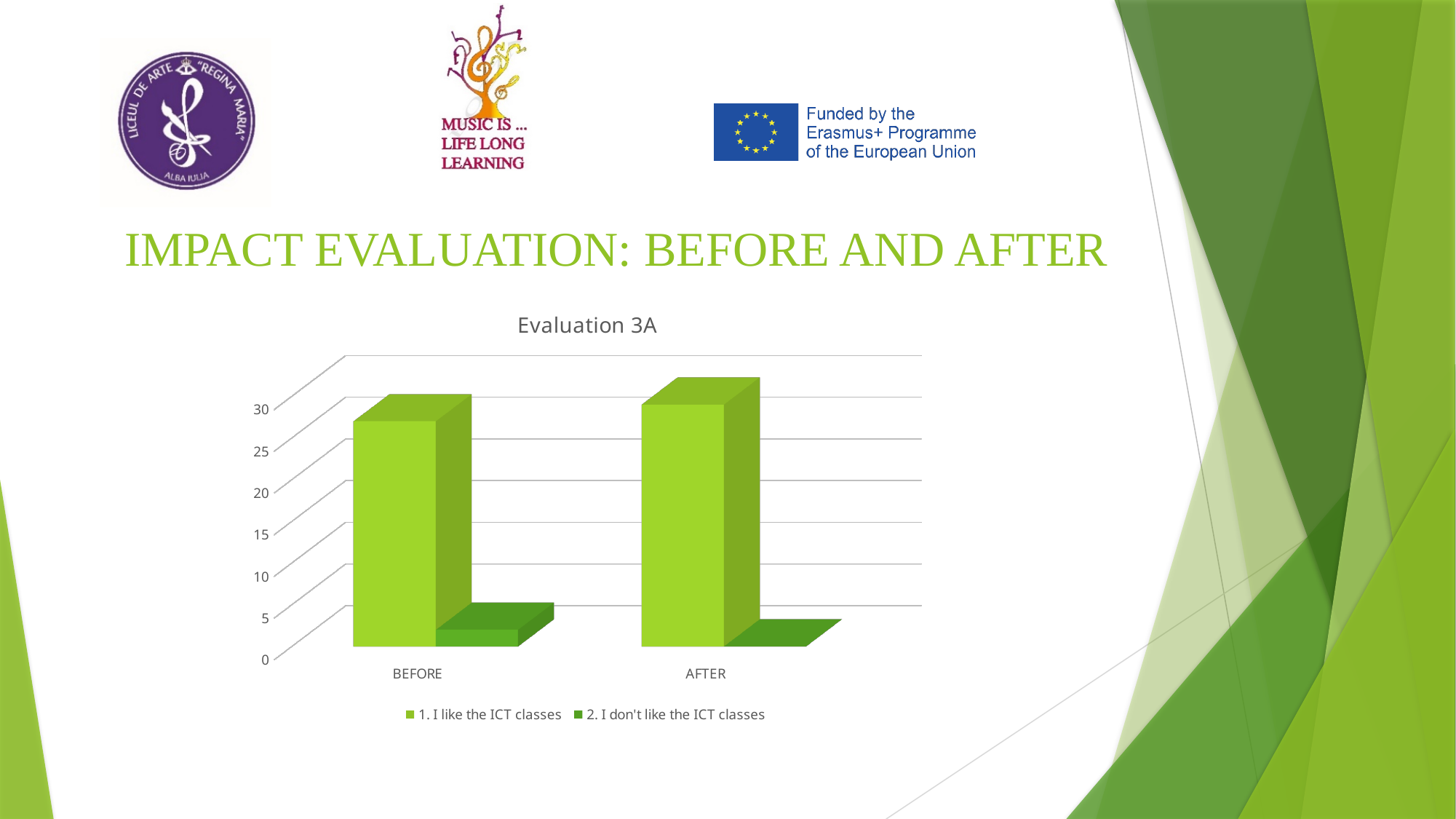
Is the value for "1. I like the ICT classes" in AFTER greater or less than 20? greater What kind of chart is shown on the slide? bar chart Does the value for "2. I don't like the ICT classes" rise or fall from BEFORE to AFTER? fall Does the value for "1. I like the ICT classes" rise or fall from BEFORE to AFTER? rise How many categories are shown on the x axis of the chart? 2 Is the value for "1. I like the ICT classes" in BEFORE greater or less than 20? greater For "2. I don't like the ICT classes", which is larger: BEFORE or AFTER? BEFORE How many series does the chart's legend list? 2 What are the two series listed in the chart's legend? 1. I like the ICT classes; 2. I don't like the ICT classes What is the title of the chart? Evaluation 3A Is the value for "2. I don't like the ICT classes" in BEFORE greater or less than 10? less